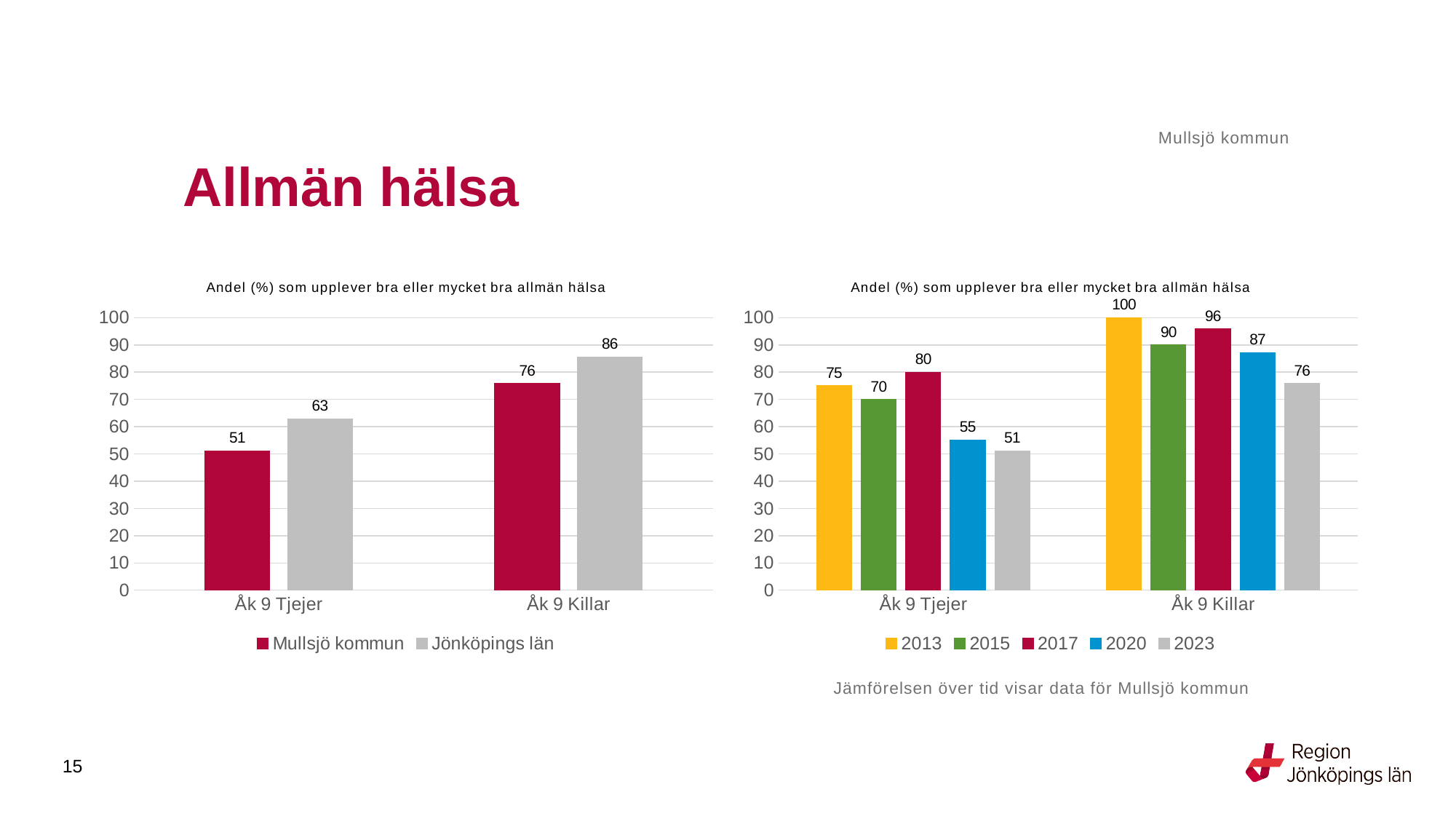
In the right chart, what is the difference between the 2013 and 2023 values for Åk 9 Killar? 24 What kind of chart is the left chart? Bar chart In the right chart, do the values for Åk 9 Killar rise or fall from 2017 to 2023? Fall In the right chart, what is the value for 2020 for Åk 9 Tjejer? 55 In the right chart, which year has the lowest value for Åk 9 Tjejer? 2023 In the left chart, which is larger for Åk 9 Killar: Mullsjö kommun or Jönköpings län? Jönköpings län In the left chart, how many series does the legend list? 2 In the left chart, what is the value for Mullsjö kommun for Åk 9 Tjejer? 51 In the left chart, what is the value for Jönköpings län for Åk 9 Killar? 86 In the right chart, what is the value for 2013 for Åk 9 Killar? 100 In the right chart, how many series does the legend list? 5 In the left chart, what is the difference between Jönköpings län and Mullsjö kommun for Åk 9 Tjejer? 12